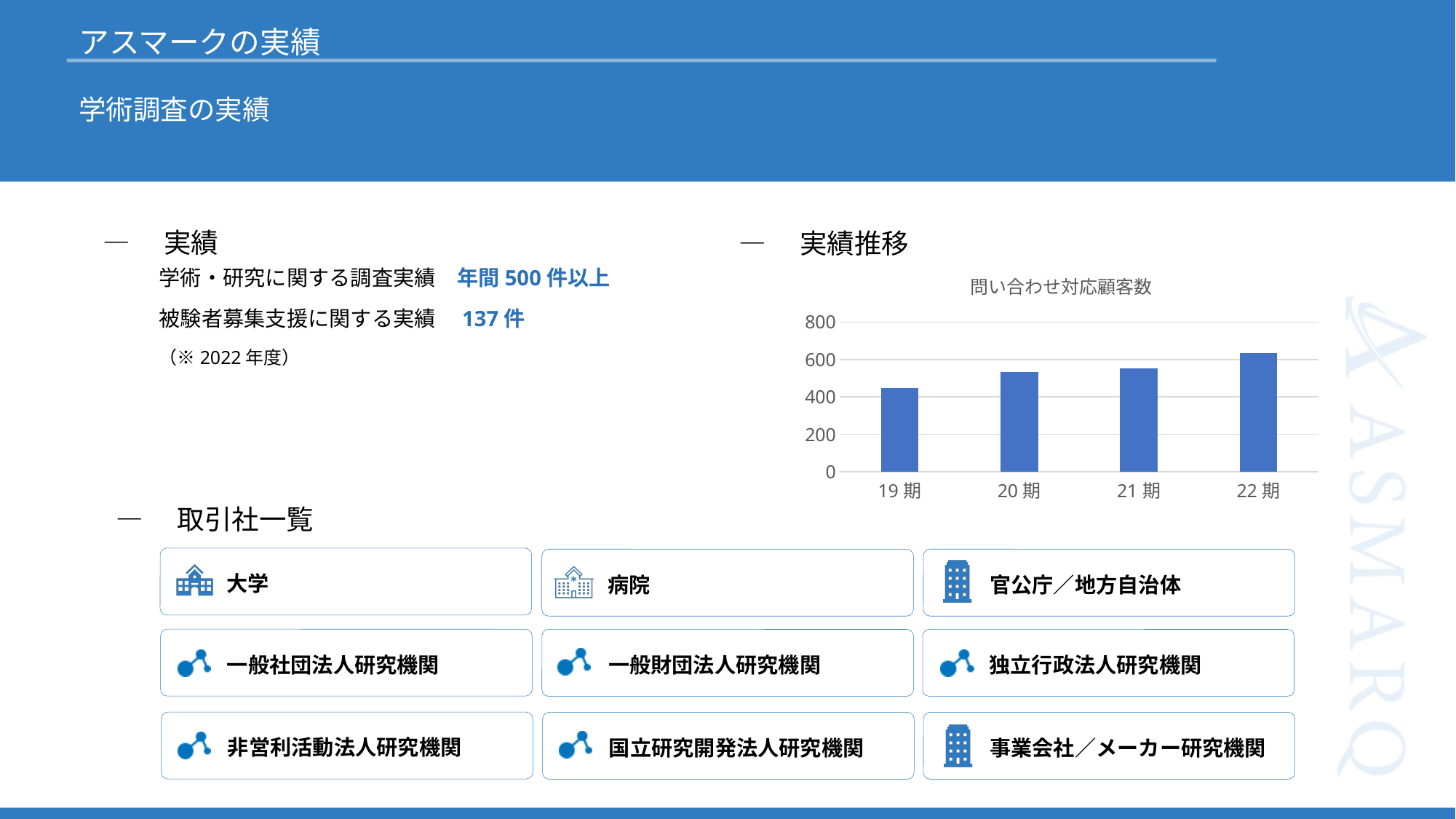
In the 問い合わせ対応顧客数 chart, is the value for 19期 greater or less than 400? greater In the 問い合わせ対応顧客数 chart, which period has the lowest value? 19期 In the 問い合わせ対応顧客数 chart, is the value for 21期 greater or less than 400? greater In the 問い合わせ対応顧客数 chart, which is larger, the value for 19期 or the value for 22期? 22期 In the 問い合わせ対応顧客数 chart, is the value for 22期 greater or less than 600? greater What is the highest value shown on the y axis of the 問い合わせ対応顧客数 chart? 800 What kind of chart is the 問い合わせ対応顧客数 chart? bar chart In the 問い合わせ対応顧客数 chart, which period has the highest value? 22期 How many periods (categories) are shown on the x axis of the 問い合わせ対応顧客数 chart? 4 What is the title of the chart on the right side of the slide? 問い合わせ対応顧客数 In the 問い合わせ対応顧客数 chart, do the values rise or fall from 19期 to 22期? rise